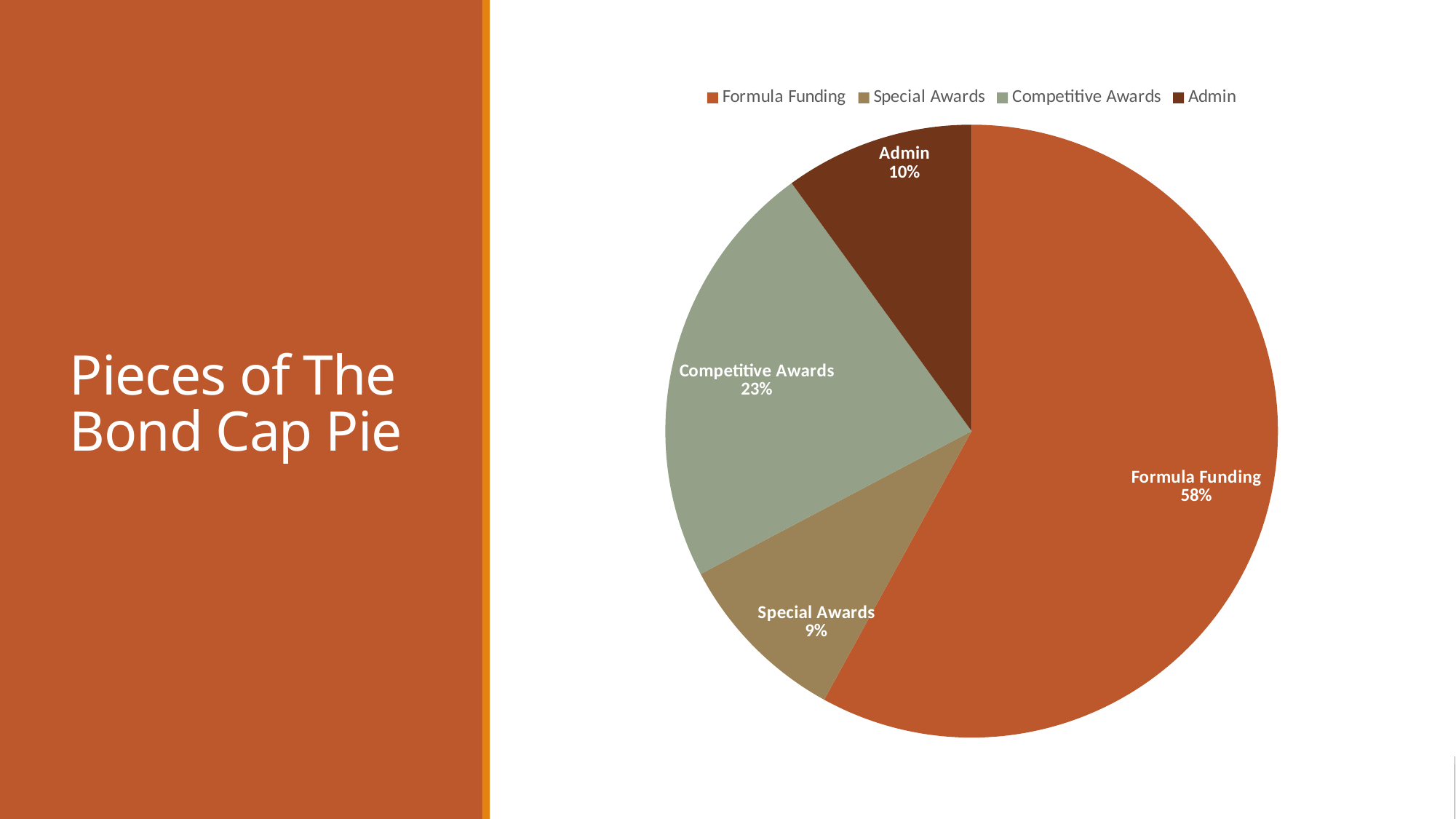
What percentage of the pie is Formula Funding? 58% What kind of chart is shown on the slide? pie chart Which slice of the pie is the largest? Formula Funding Which is larger, the Admin slice or the Special Awards slice? Admin What is the difference in percentage points between Formula Funding and Competitive Awards? 35 What is the title of the slide containing the pie chart? Pieces of The Bond Cap Pie What percentage of the pie is Competitive Awards? 23% How many entries does the legend list? 4 What percentage of the pie is Special Awards? 9% Which slice of the pie is the smallest? Special Awards How many slices does the pie chart have? 4 What percentage of the pie is Admin? 10%